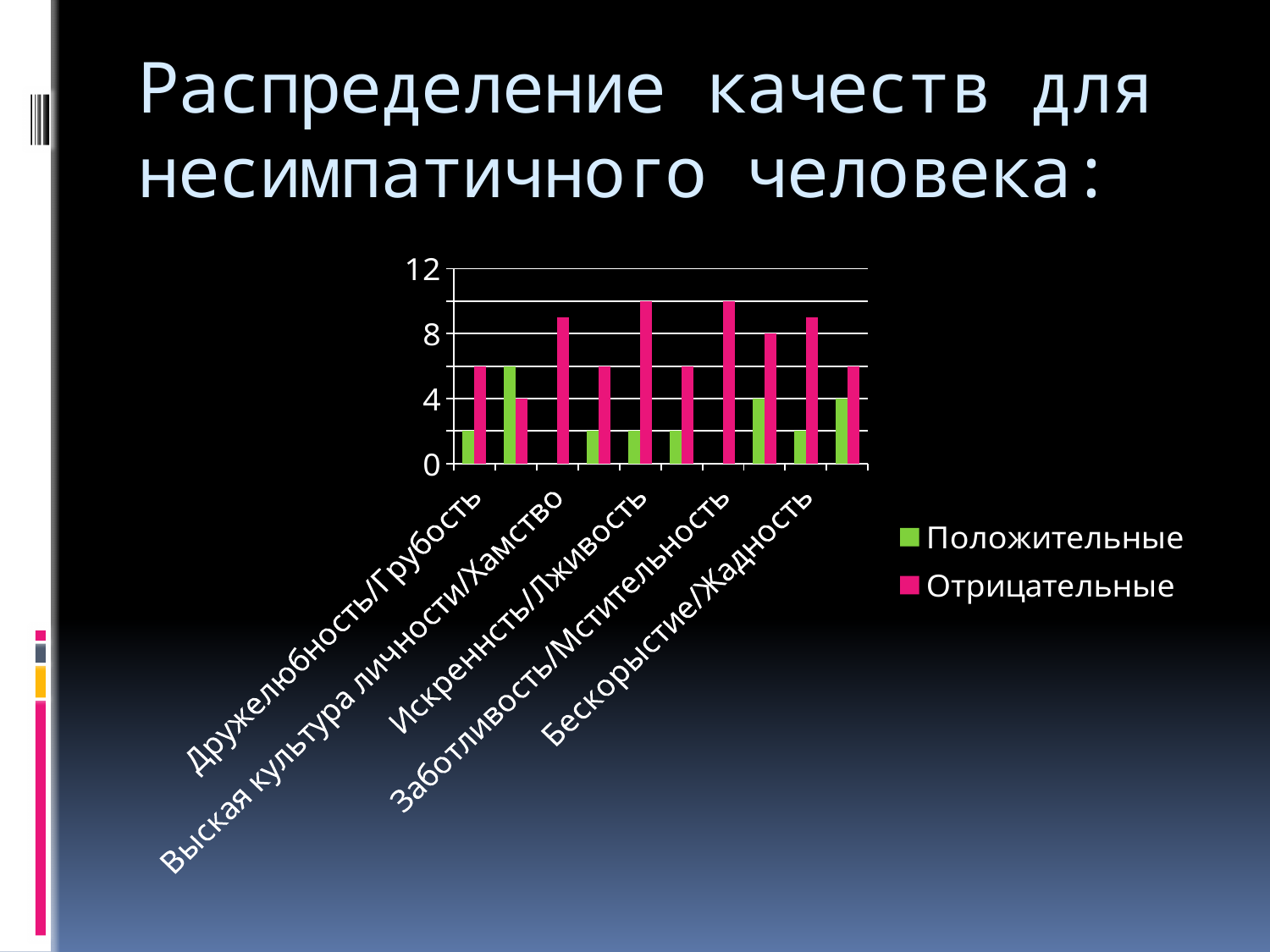
Is the Отрицательные value for Выская культура личности/Хамство greater or less than 8? greater Is the Положительные value for Бескорыстие/Жадность greater or less than 4? less How many series does the legend list? 2 Is the Отрицательные value for Заботливость/Мстительность greater or less than 8? greater What kind of chart is shown on the slide? bar chart For Дружелюбность/Грубость, which series has the larger value, Положительные or Отрицательные? Отрицательные Which series is shown in green in the legend? Положительные For Бескорыстие/Жадность, which series has the larger value, Положительные or Отрицательные? Отрицательные Which series is shown in pink in the legend? Отрицательные